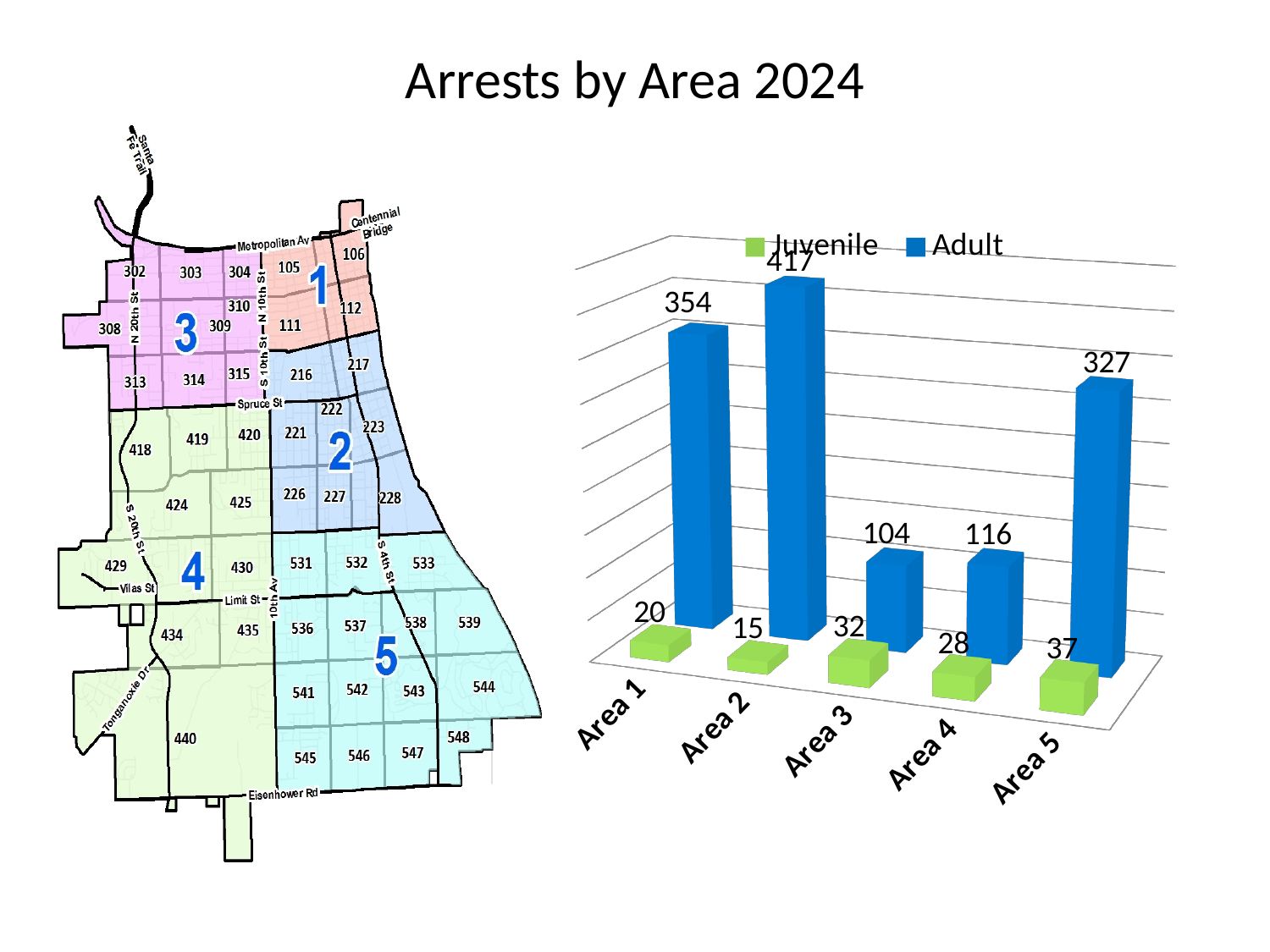
What kind of chart is shown on the slide? bar chart Which colour represents the Juvenile series in the chart? green What is the difference between the Adult values for Area 1 and Area 3? 250 How many series does the chart legend list? 2 What is the title of the slide? Arrests by Area 2024 How many areas are shown on the x axis of the chart? 5 Which area has the highest Adult value? Area 2 What is the Adult value for Area 2? 417 Which is larger, the Juvenile value for Area 4 or the Juvenile value for Area 5? Area 5 Which area has the lowest Juvenile value? Area 2 What is the Adult value for Area 5? 327 What is the Juvenile value for Area 3? 32